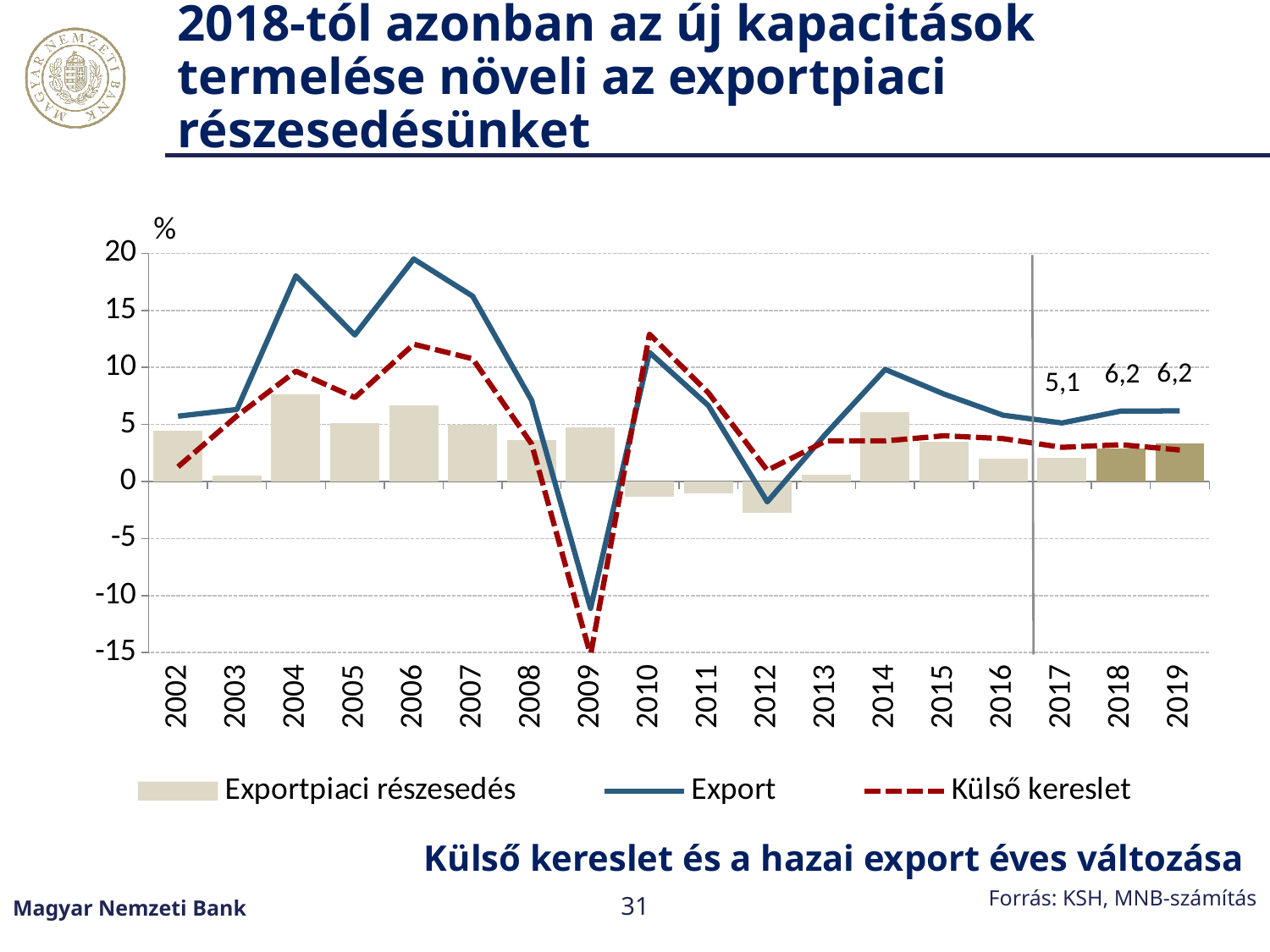
What is the difference between the Export values for 2018 and 2017? 1,1 Does the Export line rise or fall from 2014 to 2017? fall In which year does the Export line reach its highest point? 2006 In which year is the Exportpiaci részesedés bar the lowest? 2012 Is the Export value for 2004 greater or less than 15? greater What kind of chart is shown on the slide? Combined bar and line chart How many years are shown on the x axis? 18 In which year does the Export line reach its lowest point? 2009 What is the value of the Export series in 2019? 6,2 Is the Külső kereslet value for 2009 greater or less than -10? less What is the value of the Export series in 2017? 5,1 How many series does the legend list? 3